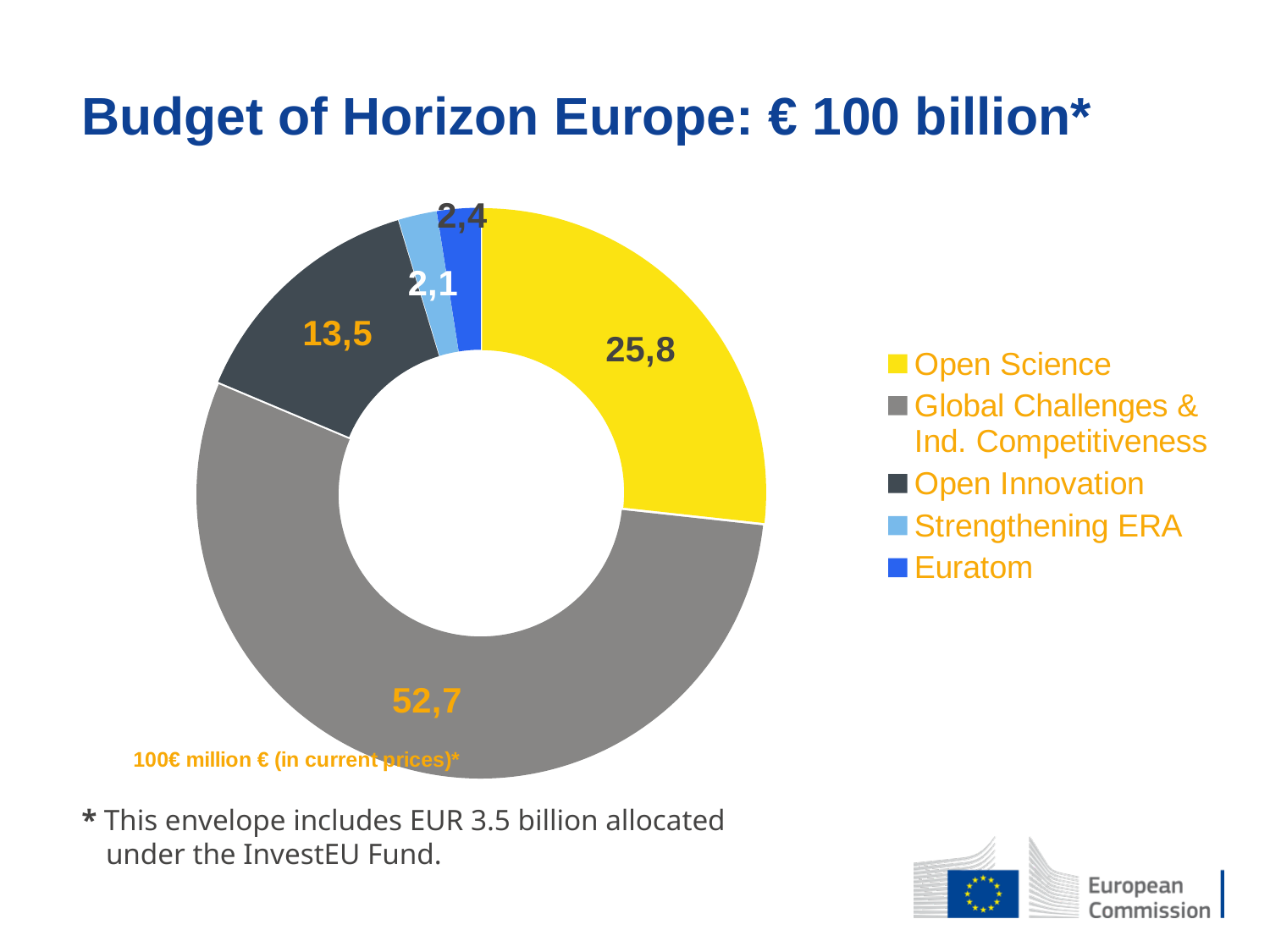
What value is shown for Strengthening ERA? 2,1 What is the difference between the values for Global Challenges & Ind. Competitiveness and Open Science? 26,9 How many categories does the chart show? 5 Which category has the largest slice? Global Challenges & Ind. Competitiveness What value is shown for Open Science? 25,8 What value is shown for Open Innovation? 13,5 Which is larger, the value for Euratom or the value for Strengthening ERA? Euratom Which category has the smallest slice? Strengthening ERA What value is shown for Global Challenges & Ind. Competitiveness? 52,7 What colour is the Open Science slice? yellow What value is shown for Euratom? 2,4 What kind of chart is shown on the slide? doughnut chart